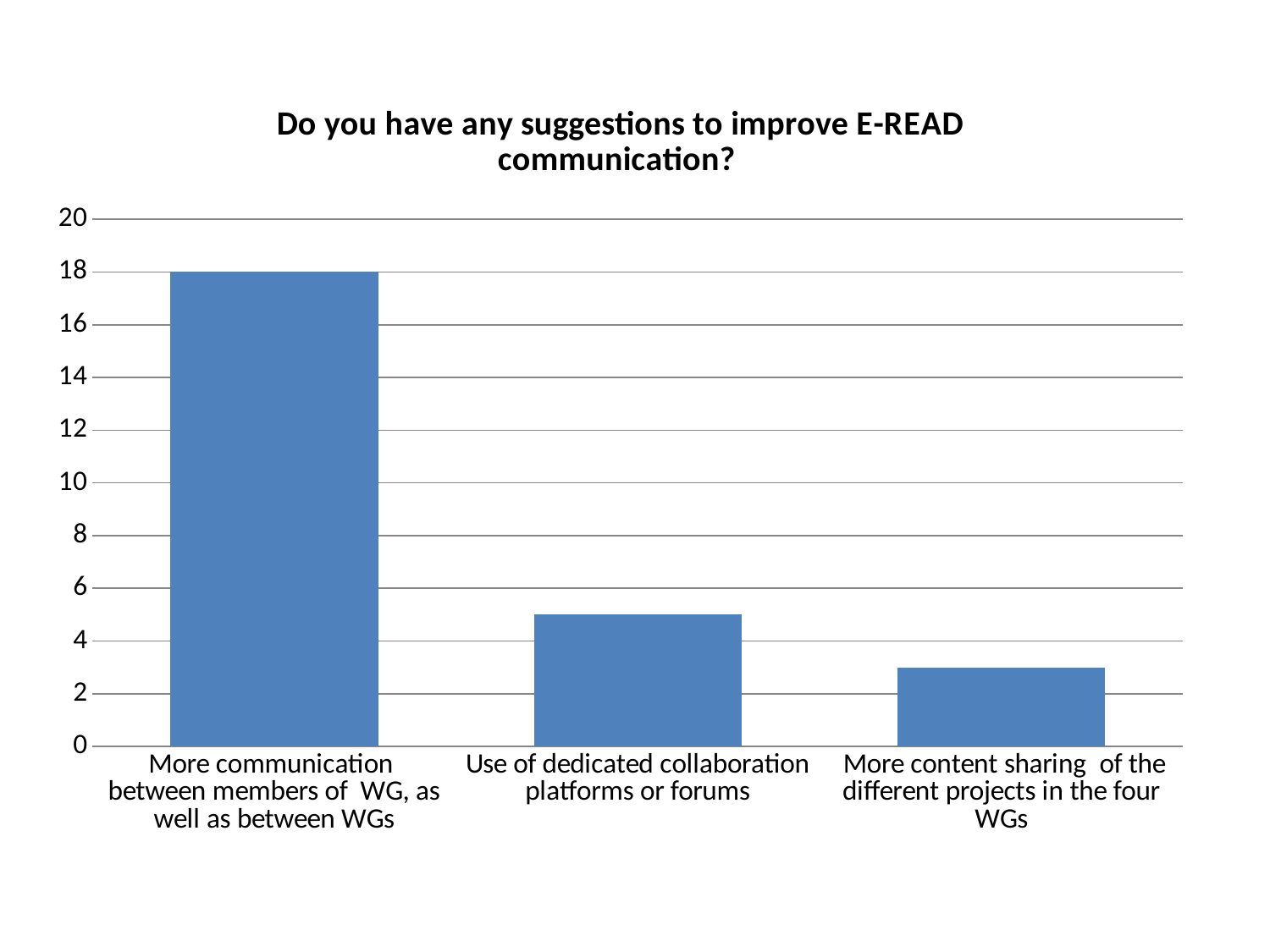
Which category has the lowest value? More content sharing of the different projects in the four WGs How many categories are shown on the x axis? 3 Is the value for "Use of dedicated collaboration platforms or forums" greater or less than 4? greater Is the value for "More content sharing of the different projects in the four WGs" greater or less than 4? less Do the values rise or fall from left to right along the x axis? fall Which category has the highest value? More communication between members of WG, as well as between WGs Is the value for "Use of dedicated collaboration platforms or forums" greater or less than 6? less What kind of chart is shown on the slide? bar chart What is the title of the chart? Do you have any suggestions to improve E-READ communication? Which is larger: the value for "Use of dedicated collaboration platforms or forums" or the value for "More content sharing of the different projects in the four WGs"? Use of dedicated collaboration platforms or forums What is the value for "More communication between members of WG, as well as between WGs"? 18